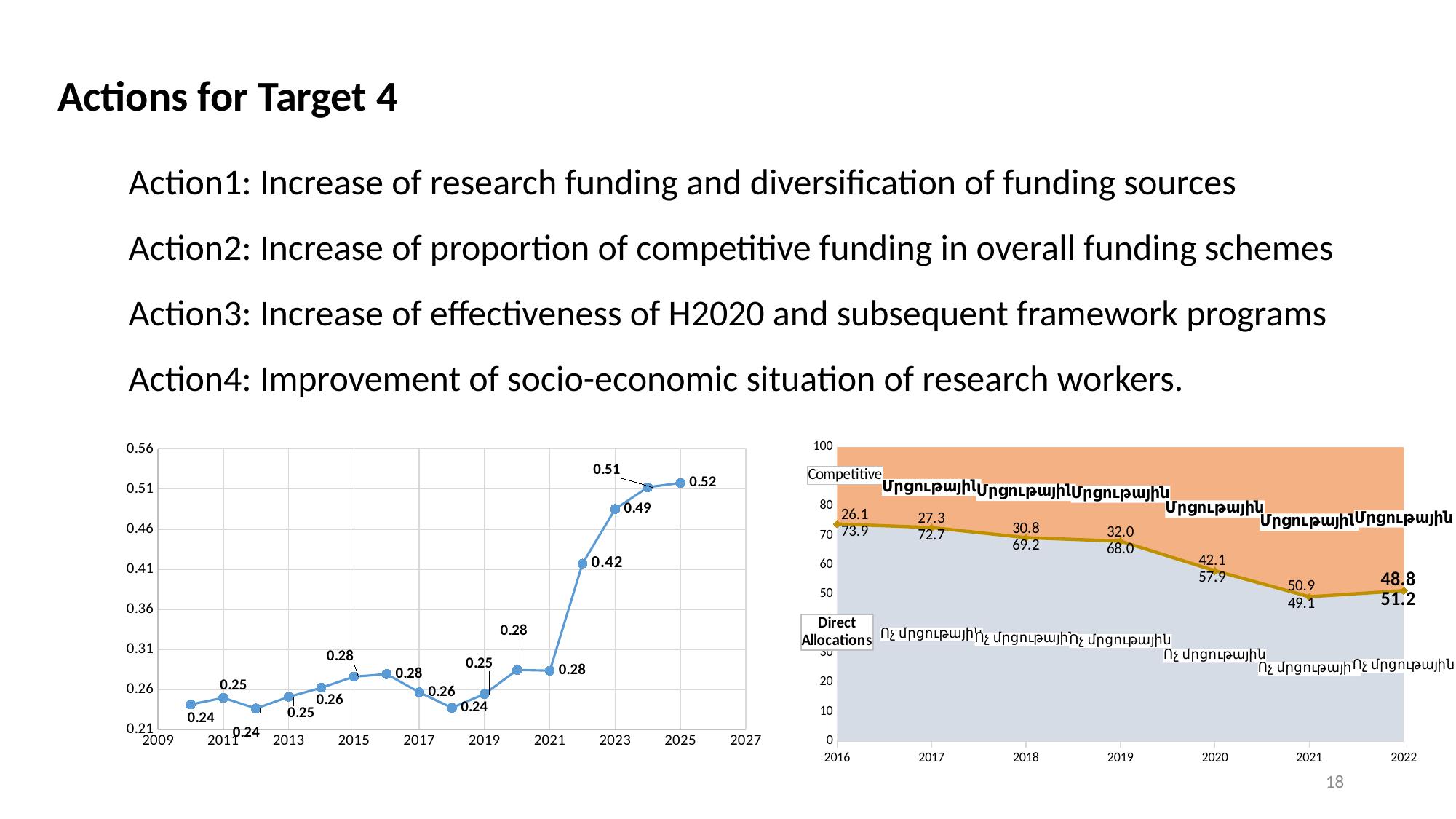
In the left chart, which year has the highest value? 2025 In the right chart, in which year is the Competitive value highest? 2021 In the left chart, what is the value plotted for 2022? 0.42 In the right chart, what is the Competitive value for 2022? 48.8 What kind of chart is the left chart? Line chart In the left chart, what is the difference between the 2025 value and the 2010 value? 0.28 In the left chart, what is the value plotted for 2025? 0.52 In the right chart, which is larger in 2019: Competitive or Direct Allocations? Direct Allocations In the right chart, what is the Direct Allocations value for 2016? 73.9 In the left chart, is the value for 2023 greater or less than 0.46? greater In the right chart, what is the difference between Direct Allocations and Competitive in 2020? 15.8 In the right chart, in which year is the Direct Allocations value lowest? 2021